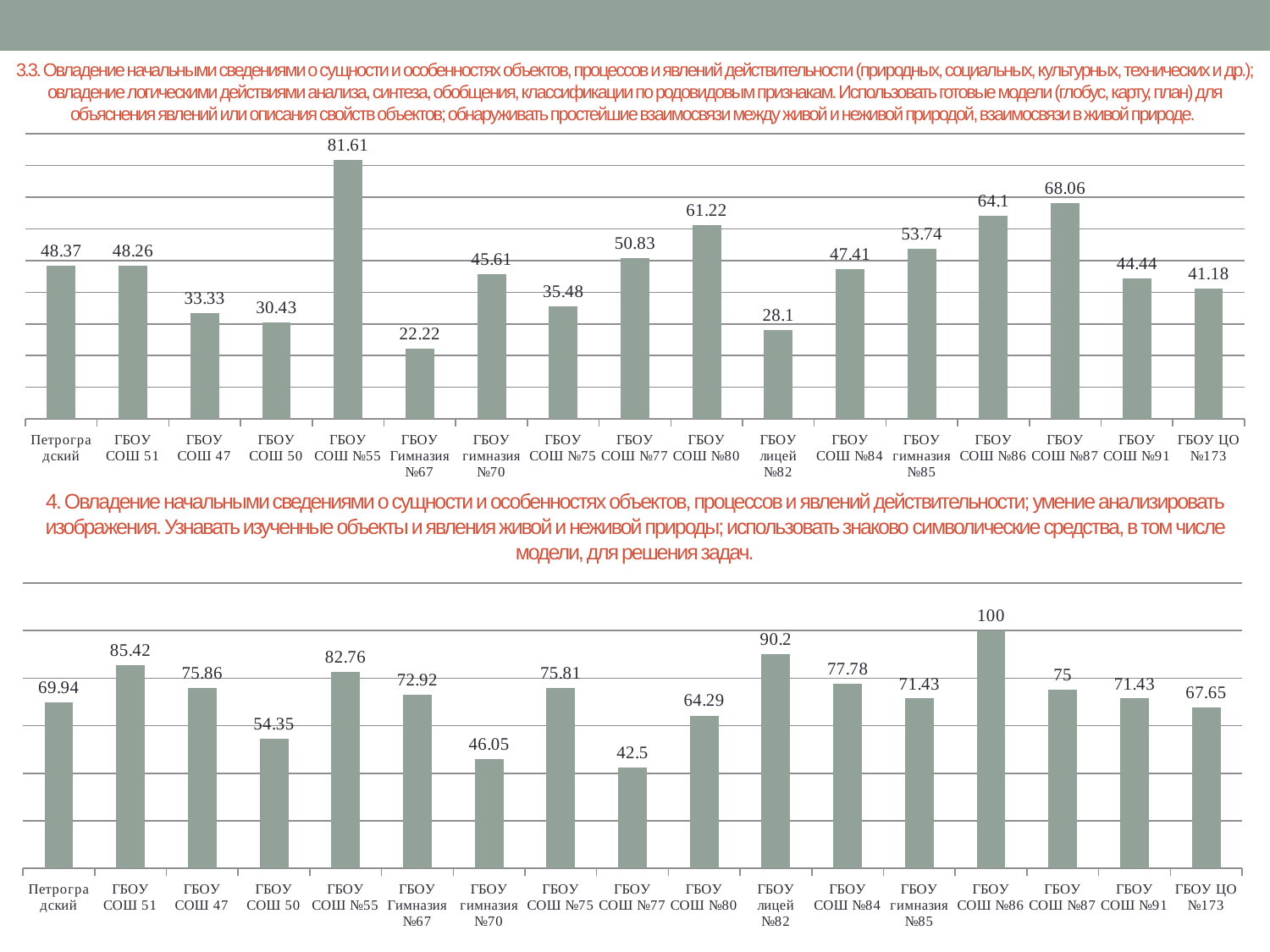
In the bottom chart, what is the difference between the values for ГБОУ СОШ 51 and Петроградский? 15.48 How many categories are shown in the top chart? 17 In the top chart, which is larger: the value for ГБОУ СОШ №80 or the value for ГБОУ гимназия №85? ГБОУ СОШ №80 In the top chart, what is the value for ГБОУ СОШ №55? 81.61 In the top chart, which category has the lowest value? ГБОУ Гимназия №67 In the top chart, what is the value for ГБОУ лицей №82? 28.1 In the bottom chart, which category has the highest value? ГБОУ СОШ №86 What type of chart is the bottom chart? Bar chart In the bottom chart, which category has the lowest value? ГБОУ СОШ №77 In the bottom chart, what is the value for ГБОУ лицей №82? 90.2 In the bottom chart, which is larger: the value for ГБОУ СОШ 50 or the value for ГБОУ гимназия №70? ГБОУ СОШ 50 In the top chart, what is the difference between the values for ГБОУ СОШ №87 and ГБОУ СОШ №86? 3.96